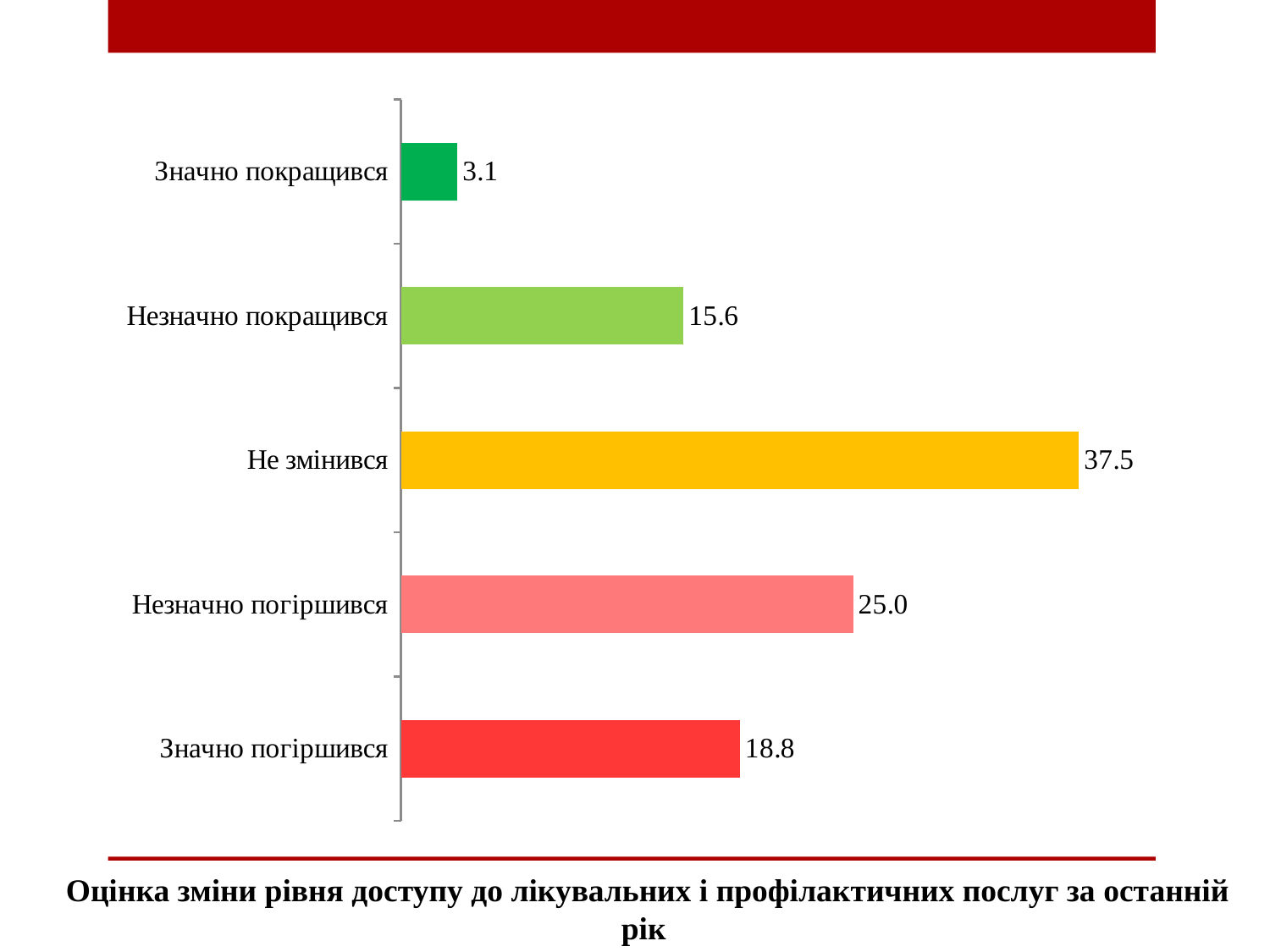
Which category has the lowest value? Значно покращився Which is larger, the value for "Незначно покращився" or the value for "Значно погіршився"? Значно погіршився How many categories are shown in the chart? 5 What is the value for "Значно покращився"? 3.1 What kind of chart is shown on the slide? Bar chart What is the value for "Незначно погіршився"? 25.0 What is the difference between the values for "Не змінився" and "Незначно погіршився"? 12.5 What is the value for "Значно погіршився"? 18.8 Which category has the highest value? Не змінився What is the difference between the values for "Значно погіршився" and "Незначно покращився"? 3.2 What colour is the bar for "Не змінився"? Yellow What is the value for "Не змінився"? 37.5